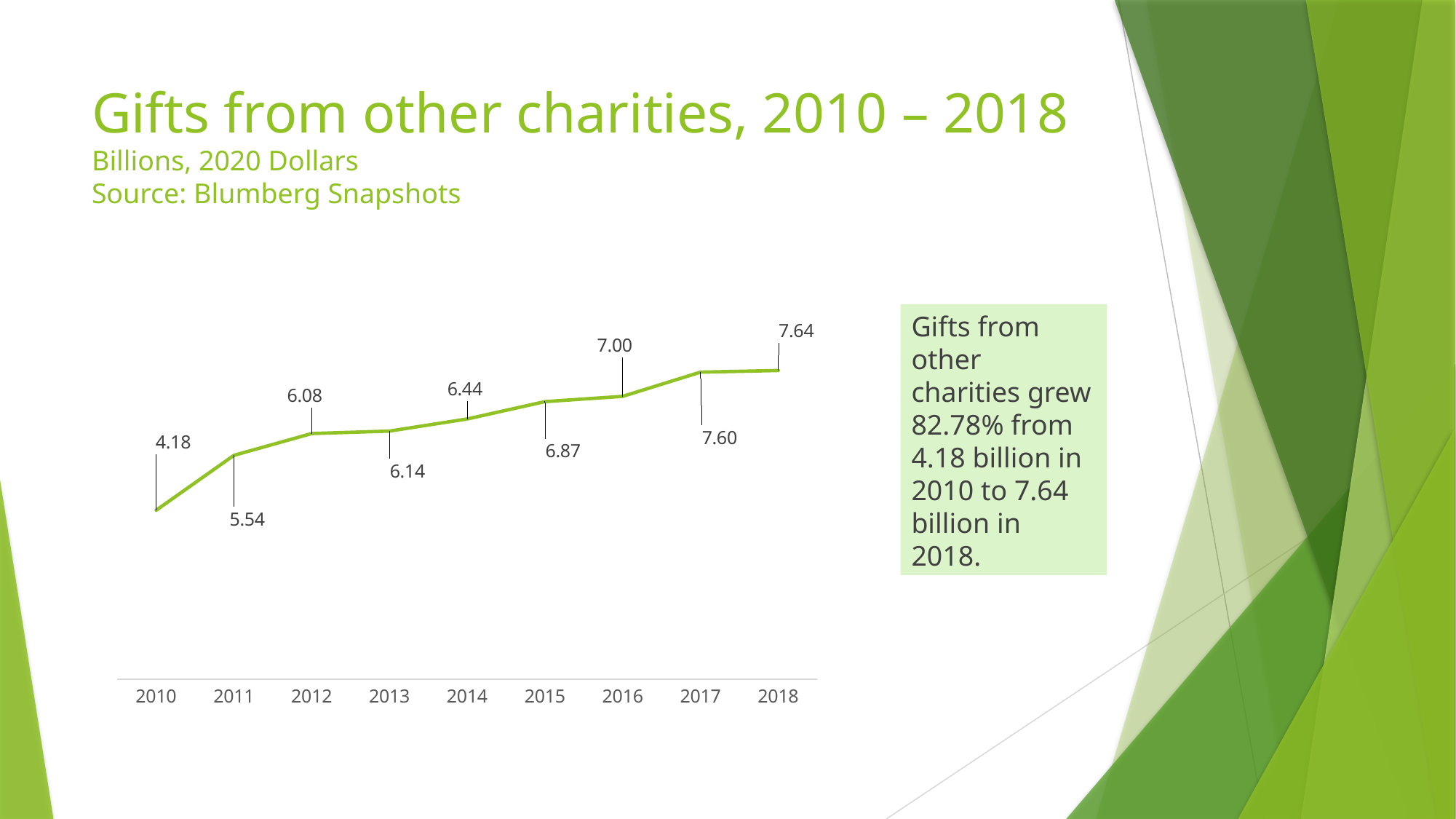
What is the value for 2014? 6.44 What is the difference between the values for 2016 and 2015? 0.13 How many years are plotted on the chart? 9 What kind of chart is shown? line chart What is the difference between the values for 2018 and 2010? 3.46 Which year has the highest value? 2018 Which year has the lowest value? 2010 What is the value for 2010? 4.18 What is the value for 2017? 7.60 Which is larger, the value for 2012 or the value for 2013? 2013 What is the source cited for the chart? Blumberg Snapshots Do the values rise or fall from 2010 to 2018? rise